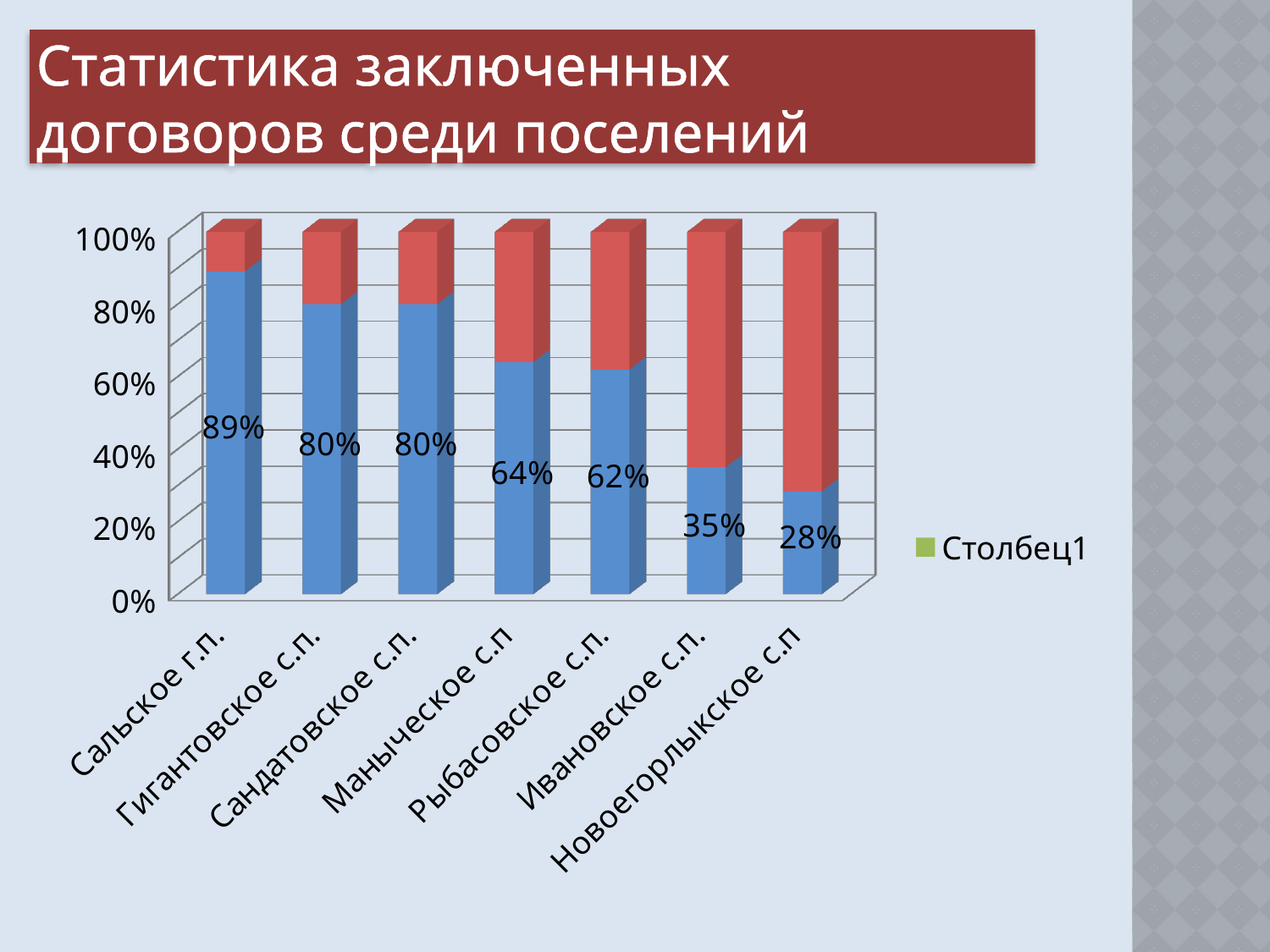
Which has the larger labelled value, Рыбасовское с.п. or Ивановское с.п.? Рыбасовское с.п. What kind of chart is shown on the slide? stacked bar chart How many settlements are shown on the x axis? 7 What is the labelled value for Маныческое с.п? 64% Which settlement has the lowest labelled value? Новоегорлыкское с.п What is the labelled value for Новоегорлыкское с.п? 28% Which settlement has the highest labelled value? Сальское г.п. What is the labelled value for Сальское г.п.? 89% Is the labelled value for Ивановское с.п. greater or less than 40%? less What is the difference between the labelled values for Сальское г.п. and Ивановское с.п.? 54% How many entries does the legend list? 1 What is the title of the slide? Статистика заключенных договоров среди поселений